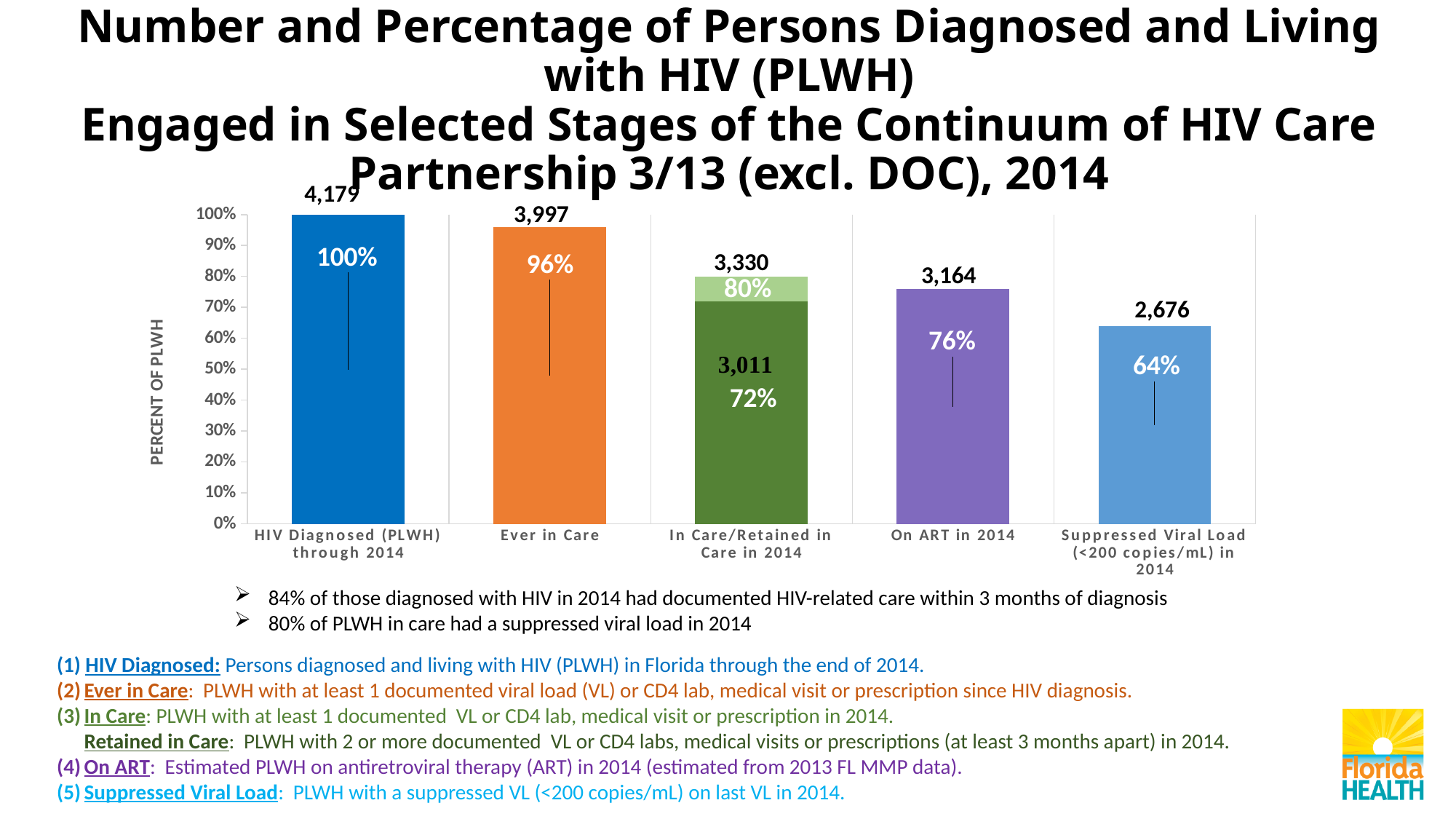
Which category has the lowest value in the chart? Suppressed Viral Load (<200 copies/mL) in 2014 What percentage is shown on the 'Ever in Care' bar? 96% What percentage is shown on the 'Suppressed Viral Load (<200 copies/mL) in 2014' bar? 64% What is the number labelled above the 'On ART in 2014' bar? 3,164 What is the difference in number of persons between 'Ever in Care' (3,997) and 'On ART in 2014' (3,164)? 833 What kind of chart is shown on the slide? bar chart How many categories are shown on the x axis of the chart? 5 What is the number of persons labelled on the bar for 'HIV Diagnosed (PLWH) through 2014'? 4,179 What percentage is shown for 'Retained in Care' (the darker green portion of the 'In Care/Retained in Care in 2014' bar)? 72% Do the bar values rise or fall moving from left to right along the x axis? fall Which is larger, the value for 'On ART in 2014' or the value for 'Suppressed Viral Load (<200 copies/mL) in 2014'? On ART in 2014 Which category has the highest value in the chart? HIV Diagnosed (PLWH) through 2014